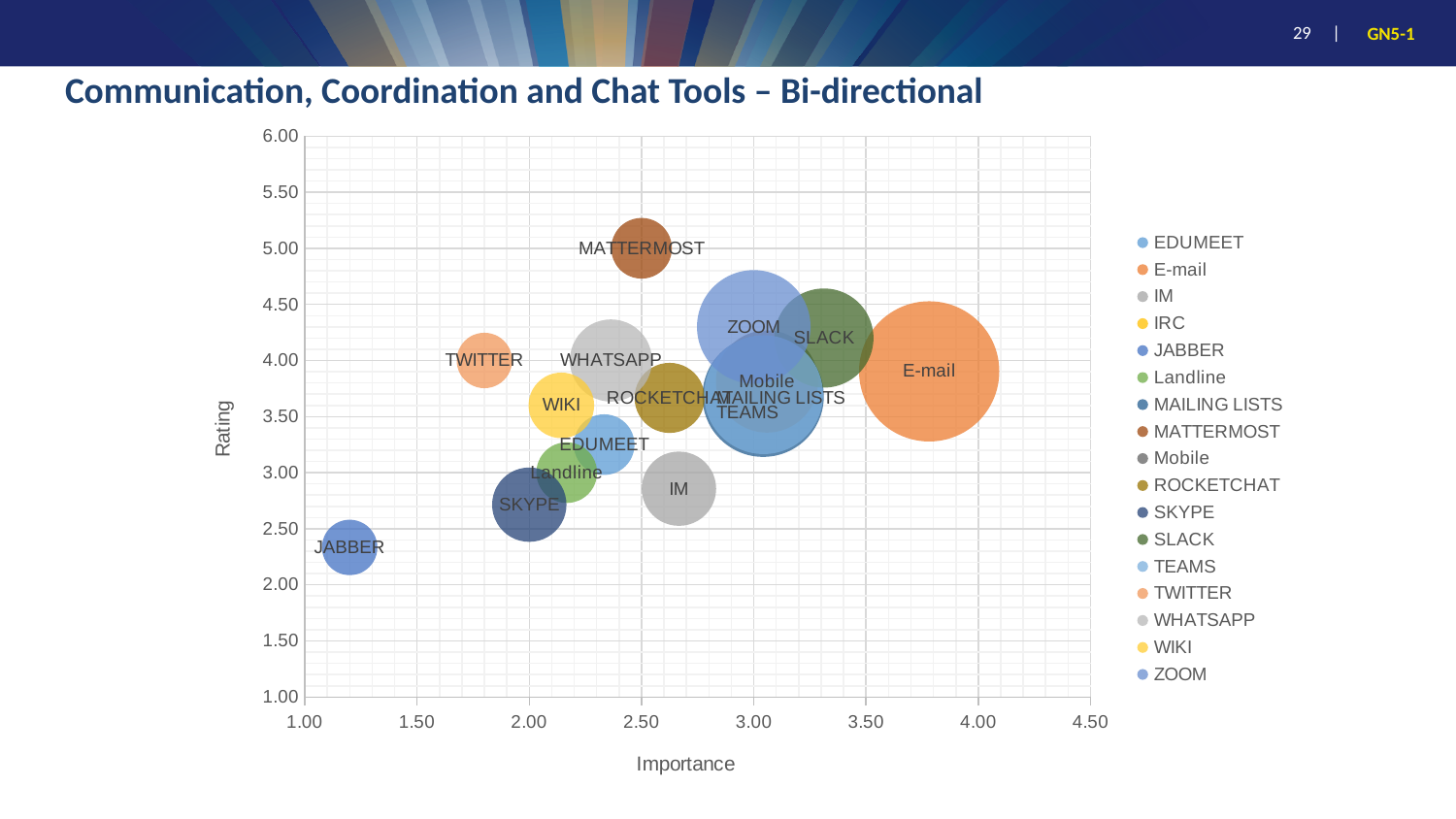
Which has the higher Rating, MATTERMOST or E-mail? MATTERMOST Is the Importance for E-mail greater or less than 3.50? greater How many tools does the legend list? 17 Is the Rating for MATTERMOST greater or less than 4.50? greater Which tool has the highest Importance? E-mail Which tool has the lowest Importance? JABBER Is the Importance for TWITTER greater or less than 2.00? less What kind of chart is shown on the slide? Bubble chart What is the label of the vertical axis? Rating Which tool has the highest Rating? MATTERMOST